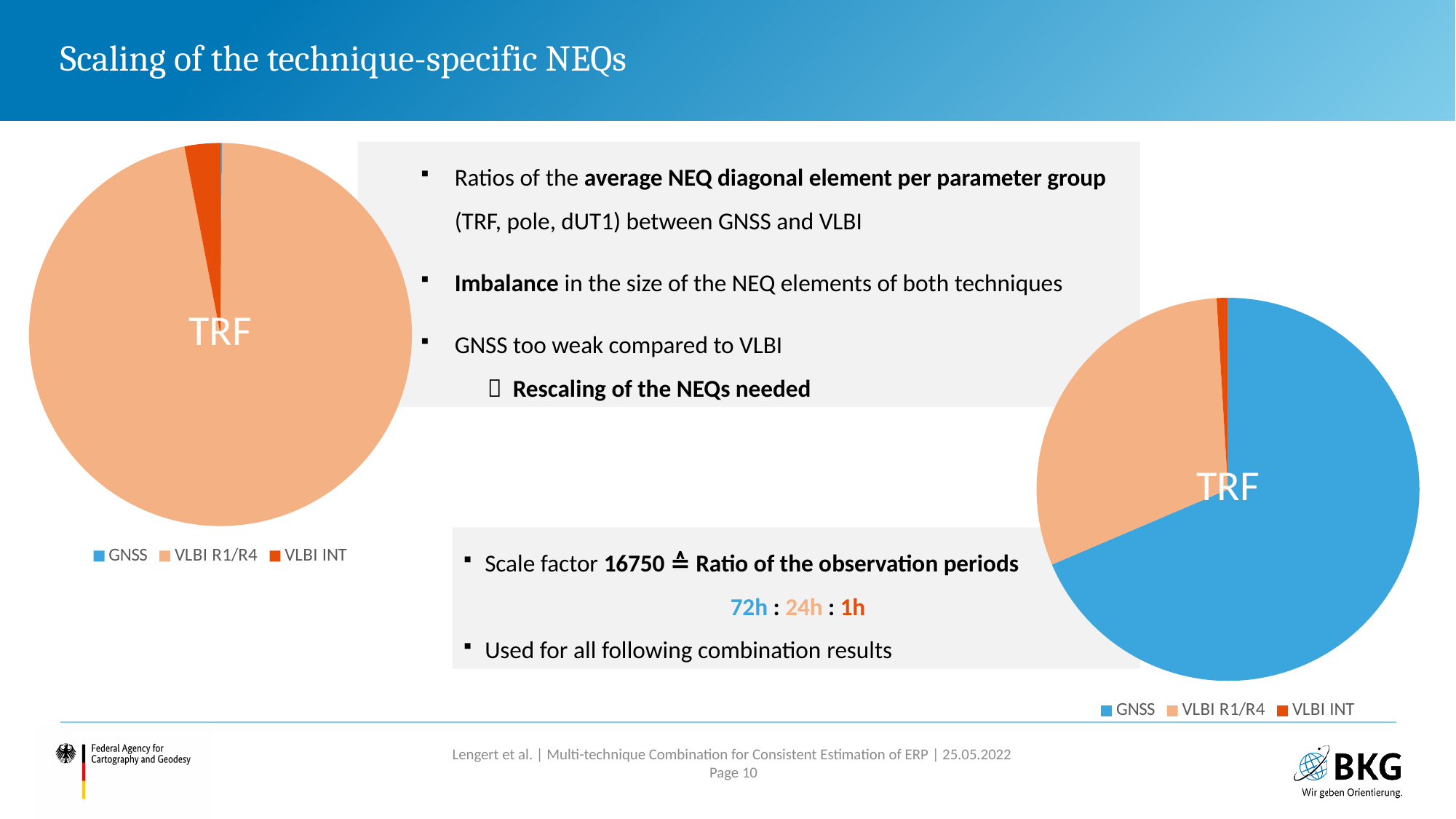
What label is printed in the centre of both pie charts? TRF How many entries does the legend of the left pie chart list? 3 In the left pie chart, which category has the smallest slice? GNSS In the left pie chart, which slice is larger, VLBI INT or GNSS? VLBI INT How many entries does the legend of the right pie chart list? 3 What kind of chart is the right chart on the slide? pie chart What kind of chart is the left chart on the slide? pie chart In the left pie chart, which category has the largest slice? VLBI R1/R4 Which colour represents GNSS in the legend of the pie charts? blue In the right pie chart, which category has the smallest slice? VLBI INT In the right pie chart, which category has the largest slice? GNSS In the right pie chart, which slice is larger, GNSS or VLBI R1/R4? GNSS